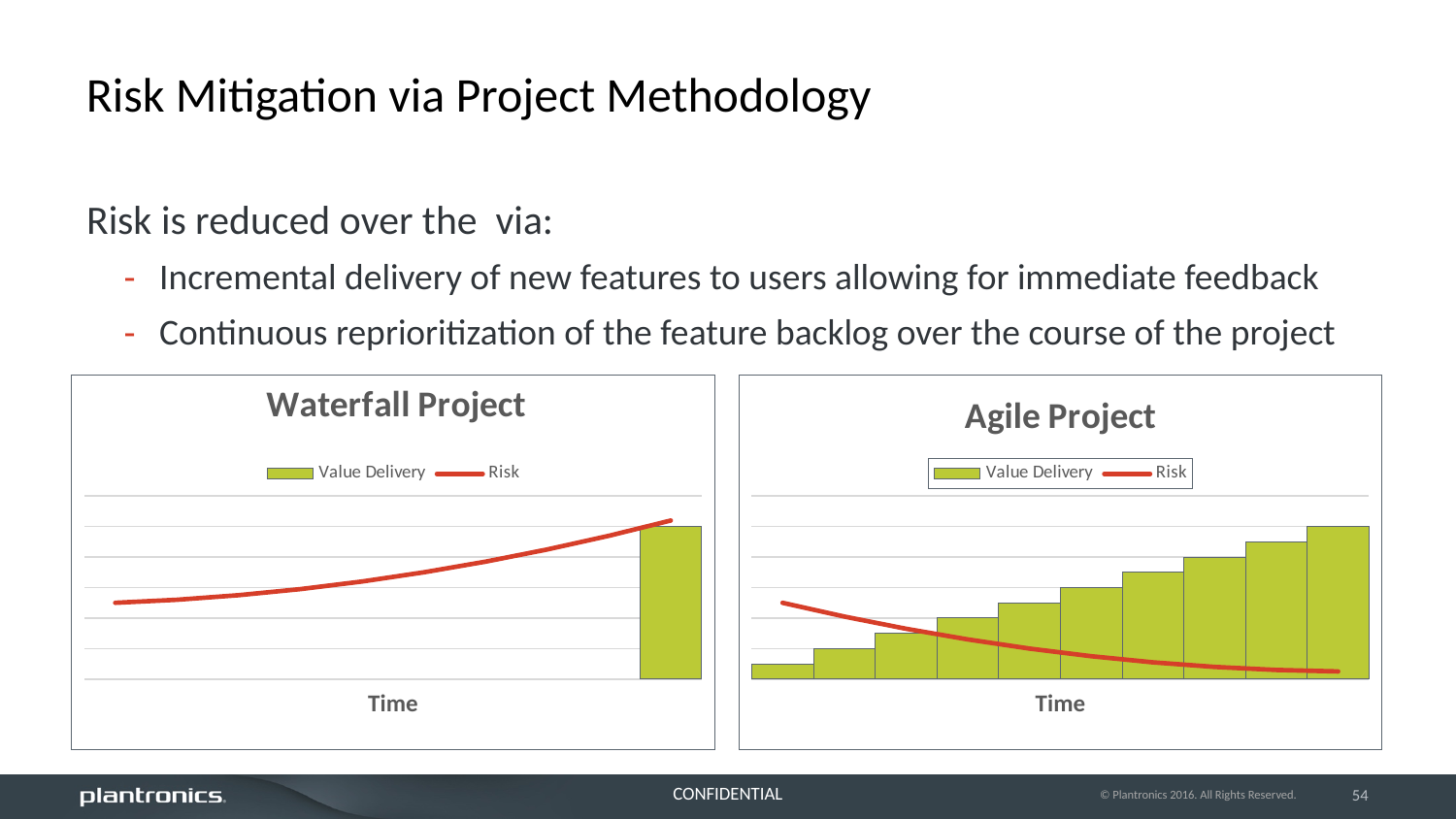
In the Agile Project chart, do the Value Delivery bars rise or fall from left to right? Rise In the Waterfall Project chart, does the Risk line rise or fall along the x axis? Rises In the Agile Project chart, which series is drawn as green bars? Value Delivery In the Agile Project chart, what is the label on the x axis? Time In the Agile Project chart, how many series does the legend list? 2 In the Waterfall Project chart, which series is drawn as a red line? Risk In the Agile Project chart, does the Risk line rise or fall along the x axis? Falls In the Waterfall Project chart, what kind of chart is it? A combined bar and line chart In the Agile Project chart, how many Value Delivery bars are plotted? 10 In the Waterfall Project chart, how many Value Delivery bars are plotted? 1